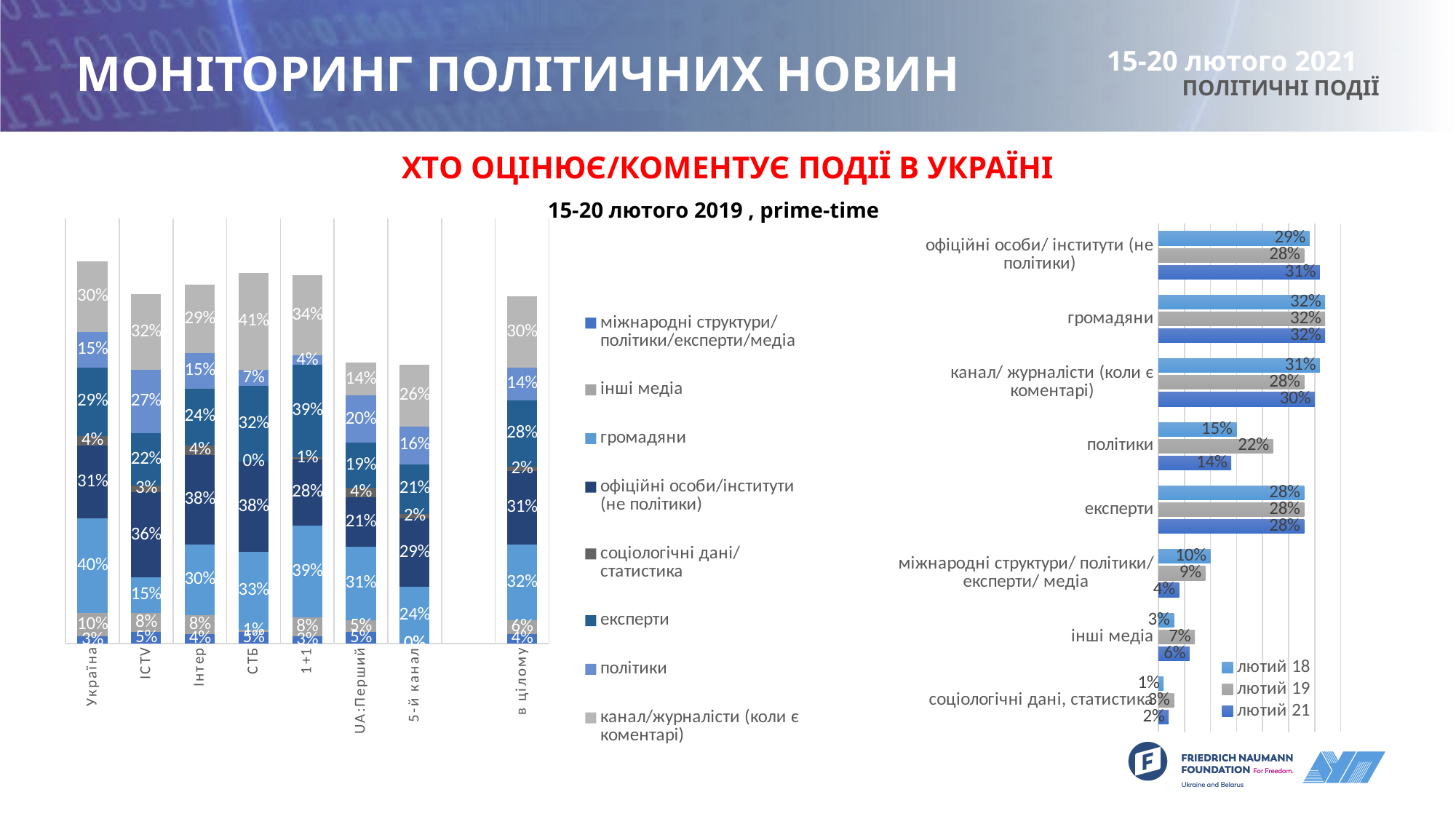
In the right-hand horizontal bar chart, is the value for політики larger in лютий 18 or лютий 21? лютий 18 In the left-hand stacked bar chart, what is the канал/журналісти (коли є коментарі) share for СТБ? 41% In the left-hand stacked bar chart, which channel has the larger громадяни share, 1+1 or ICTV? 1+1 In the right-hand horizontal bar chart, which category has the lowest value for лютий 18? соціологічні дані, статистика In the right-hand horizontal bar chart, what is the value for політики in лютий 19? 22% What kind of chart is the left-hand chart? Stacked bar chart How many series does the legend of the left-hand stacked bar chart list? 8 How many series does the legend of the right-hand horizontal bar chart list? 3 In the right-hand horizontal bar chart, what is the difference between the лютий 19 and лютий 21 values for міжнародні структури/ політики/ експерти/ медіа? 5 percentage points How many channel categories are shown on the x axis of the left-hand stacked bar chart? 8 In the left-hand stacked bar chart, what is the експерти share for в цілому? 28% In the left-hand stacked bar chart, what is the громадяни share for Україна? 40%